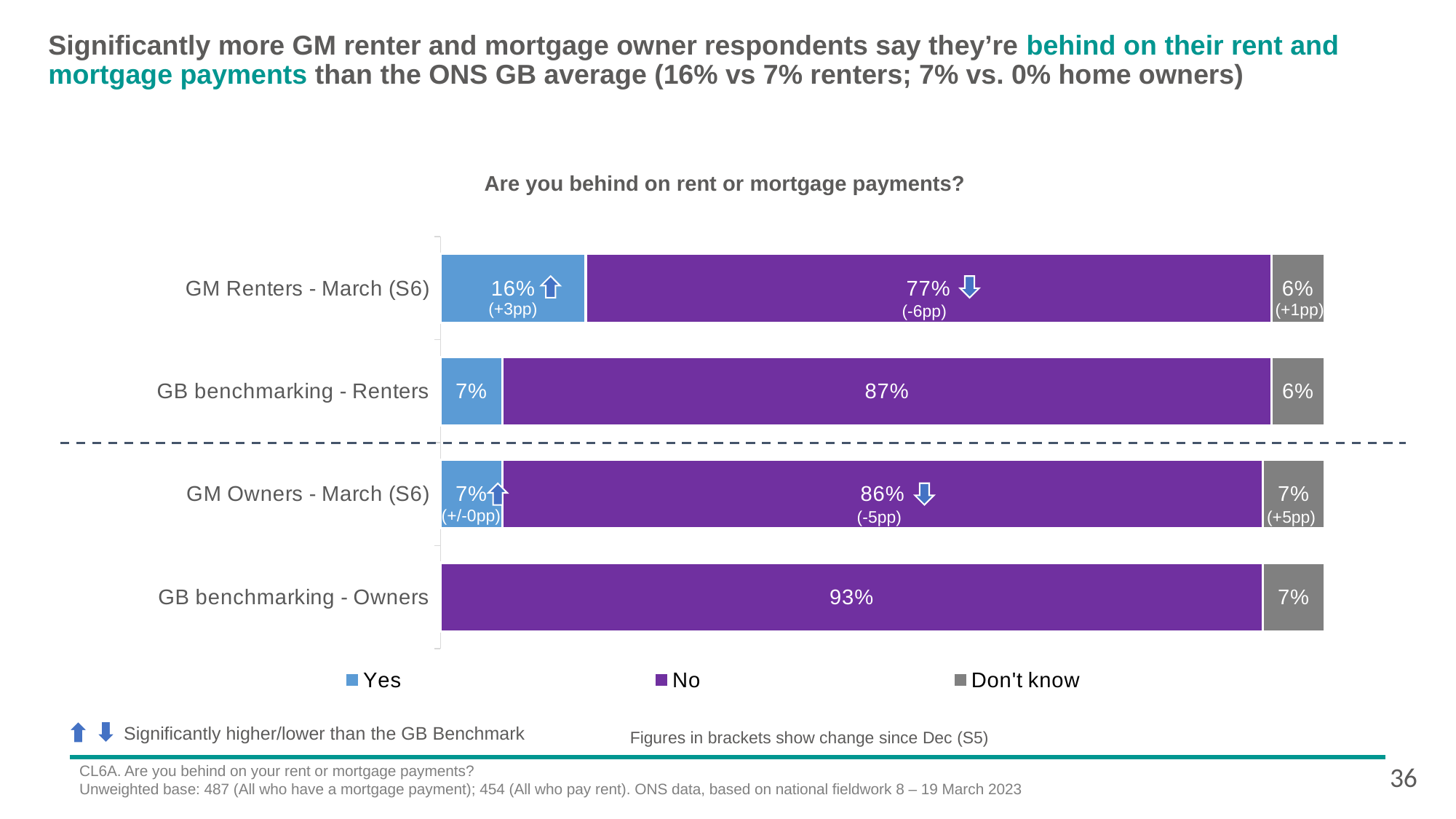
How many series does the legend list? 3 Which has a larger No percentage: GM Owners - March (S6) or GB benchmarking - Owners? GB benchmarking - Owners Which category has the highest No percentage? GB benchmarking - Owners What percentage of GB benchmarking - Renters answered No? 87% How many categories are shown on the chart? 4 What percentage of GM Renters - March (S6) answered Yes? 16% What is the difference in the Yes percentage between GM Renters - March (S6) and GB benchmarking - Renters? 9 percentage points What is the title of the chart? Are you behind on rent or mortgage payments? What type of chart is shown? Stacked bar chart Which category has the lowest No percentage? GM Renters - March (S6) What percentage of GB benchmarking - Owners answered No? 93% What percentage of GM Owners - March (S6) answered Don't know? 7%